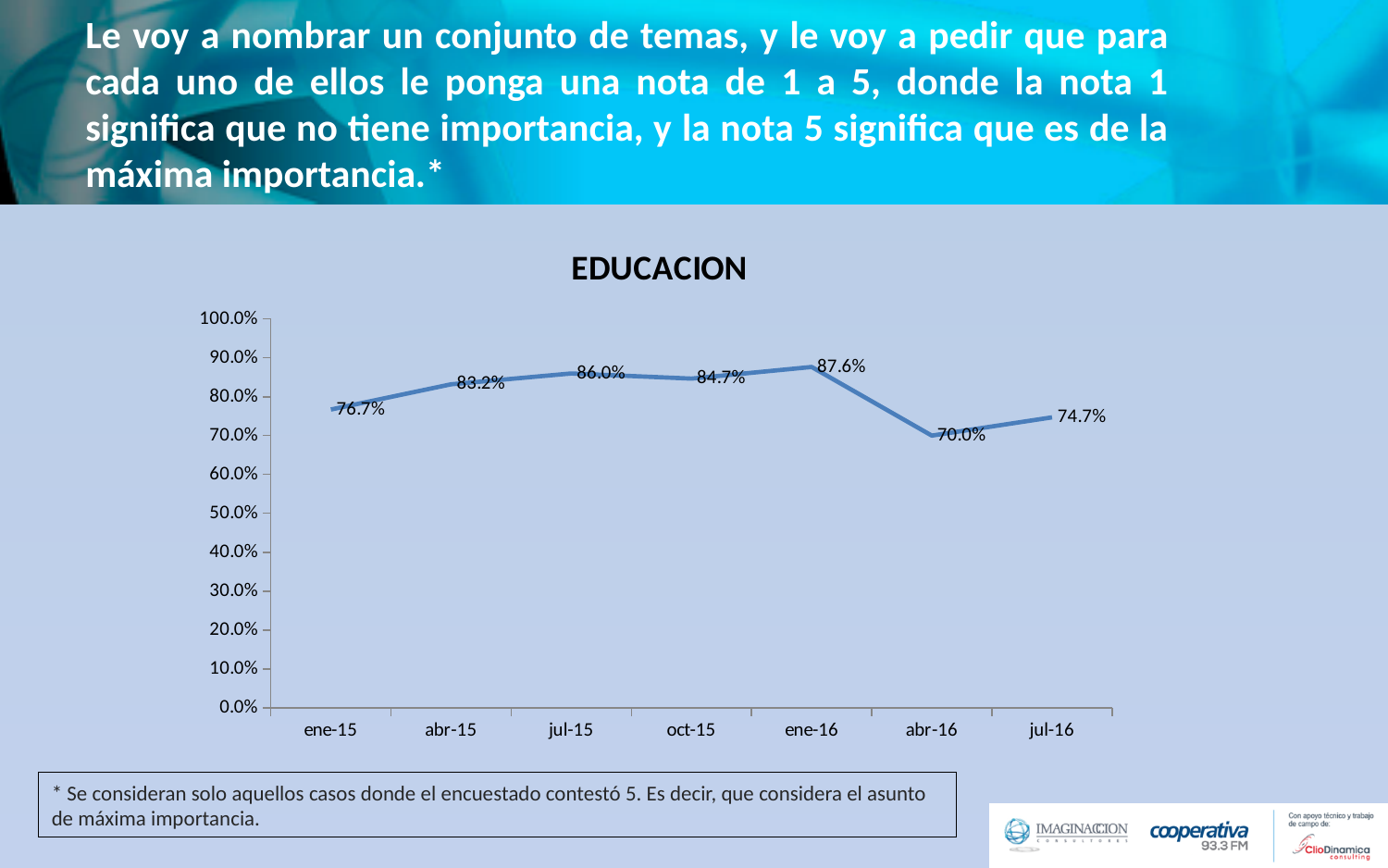
What is the title of the chart on the slide? EDUCACION What kind of chart is the EDUCACION chart? line chart Which period has the highest value in the EDUCACION chart? ene-16 What is the value for ene-15 in the EDUCACION chart? 76.7% Does the value in the EDUCACION chart rise or fall from ene-16 to abr-16? fall Which period has the lowest value in the EDUCACION chart? abr-16 What is the difference between the values for ene-16 and abr-16 in the EDUCACION chart? 17.6% Which is larger in the EDUCACION chart, the value for jul-15 or the value for jul-16? jul-15 What is the value for ene-16 in the EDUCACION chart? 87.6% How many data points are plotted in the EDUCACION chart? 7 What is the value for abr-16 in the EDUCACION chart? 70.0% Is the value for oct-15 in the EDUCACION chart greater or less than 80.0%? greater